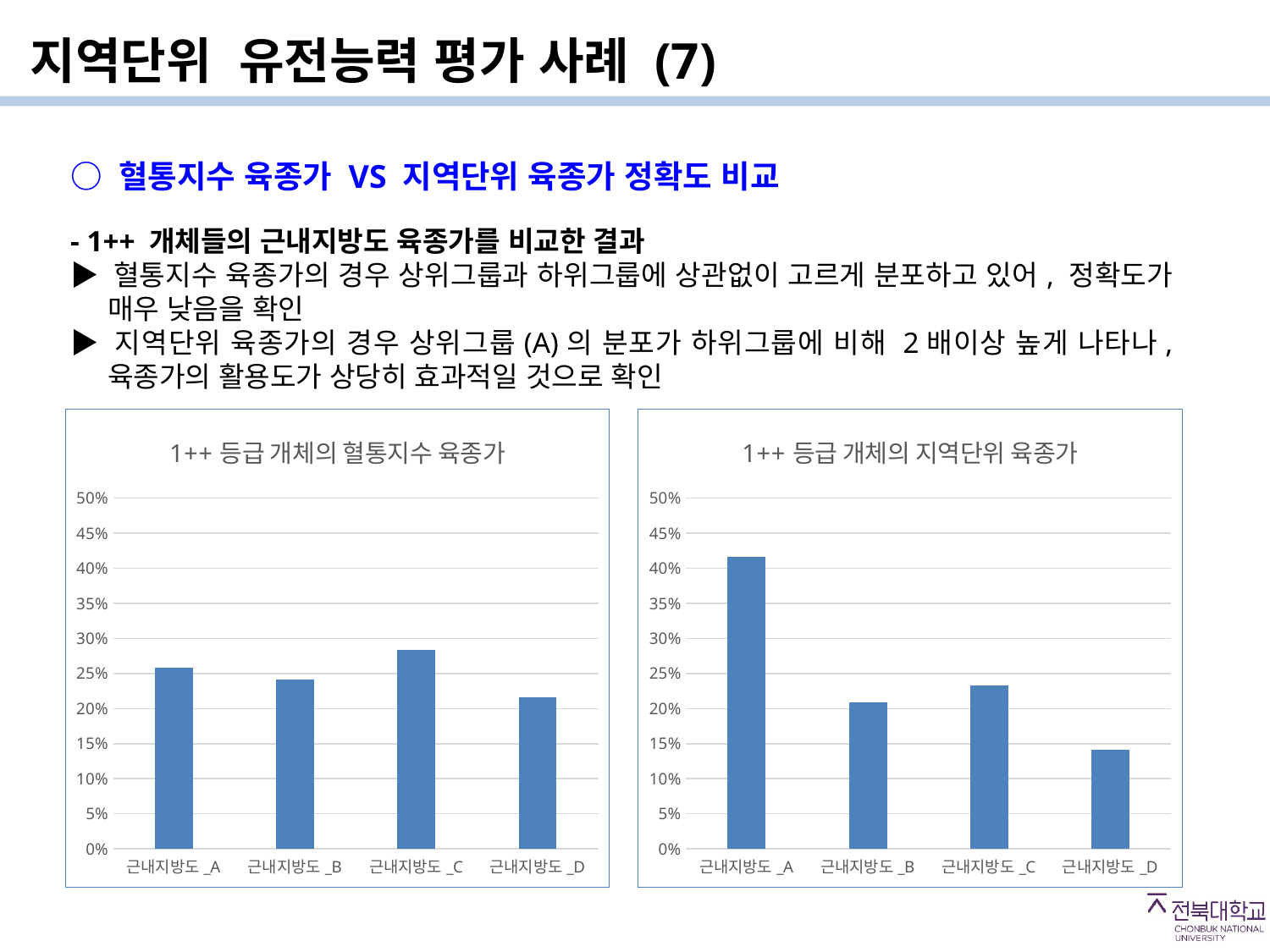
In the left chart titled "1++ 등급 개체의 혈통지수 육종가", is the value for 근내지방도 _D greater or less than 25%? less In the right chart titled "1++ 등급 개체의 지역단위 육종가", is the value for 근내지방도 _A greater or less than 40%? greater How many categories are shown on the x axis of the right chart titled "1++ 등급 개체의 지역단위 육종가"? 4 In the right chart titled "1++ 등급 개체의 지역단위 육종가", which category has the highest value? 근내지방도 _A What is the title of the right chart on the slide? 1++ 등급 개체의 지역단위 육종가 In the left chart titled "1++ 등급 개체의 혈통지수 육종가", which category has the lowest value? 근내지방도 _D In the left chart titled "1++ 등급 개체의 혈통지수 육종가", which category has the highest value? 근내지방도 _C In the right chart titled "1++ 등급 개체의 지역단위 육종가", which is larger, the value for 근내지방도 _A or 근내지방도 _B? 근내지방도 _A In the right chart titled "1++ 등급 개체의 지역단위 육종가", is the value for 근내지방도 _D greater or less than 20%? less What kind of chart is the left chart titled "1++ 등급 개체의 혈통지수 육종가"? bar chart In the right chart titled "1++ 등급 개체의 지역단위 육종가", which category has the lowest value? 근내지방도 _D